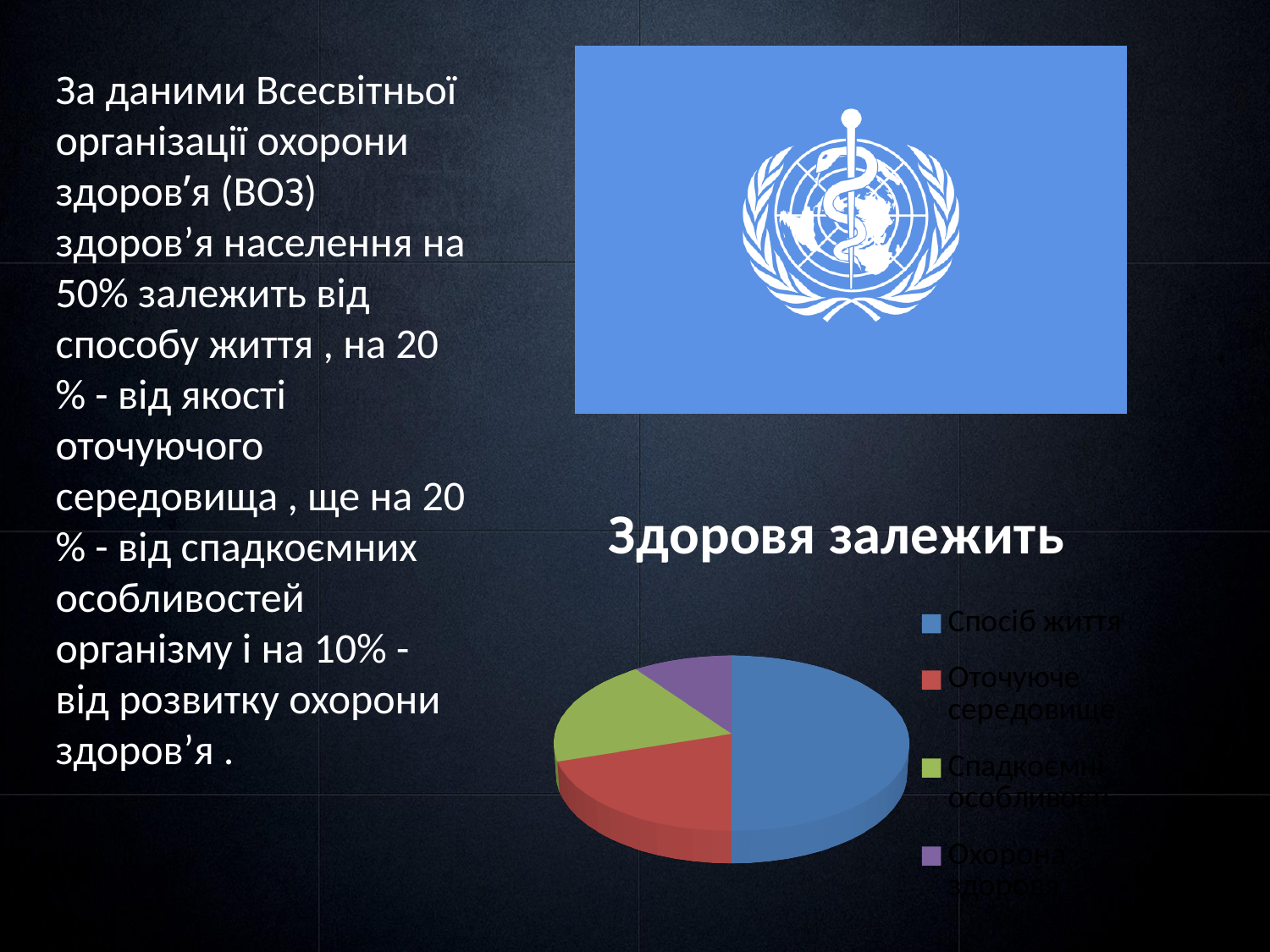
What is the title of the chart on the slide? Здоровя залежить Which slice is larger: Оточуюче середовище or Охорона здоров'я? Оточуюче середовище Which slice is larger: Спадкоємні особливості or Охорона здоров'я? Спадкоємні особливості Which category has the largest slice of the pie chart? Спосіб життя How many entries does the chart legend list? 4 What kind of chart is shown on the slide? pie chart Which category has the smallest slice of the pie chart? Охорона здоровя How many slices does the pie chart have? 4 Which slice is larger: Спосіб життя or Оточуюче середовище? Спосіб життя What colour is the Спосіб життя slice in the pie chart? blue